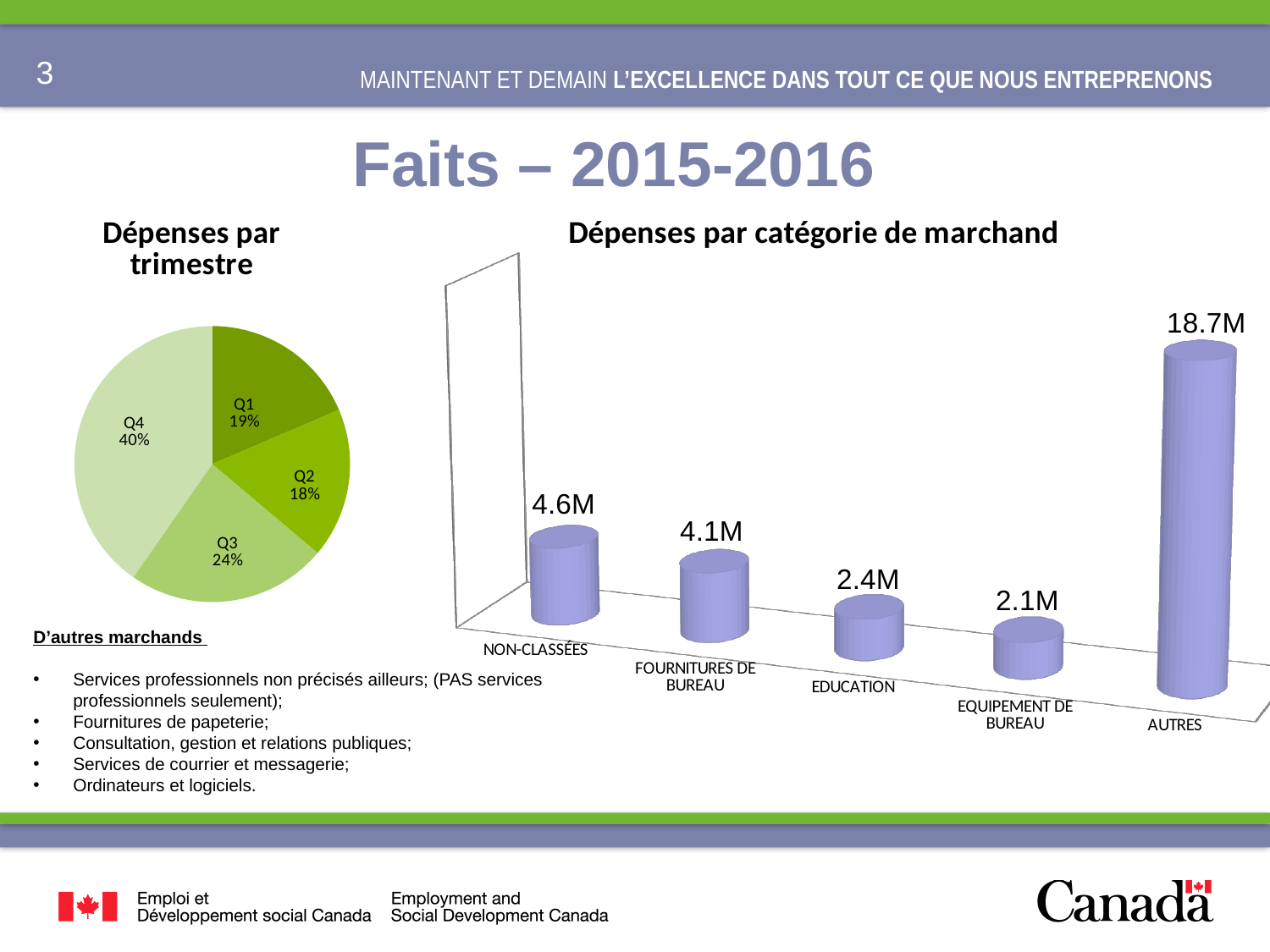
In the 'Dépenses par catégorie de marchand' chart, what is the value for EDUCATION? 2.4M In the 'Dépenses par catégorie de marchand' chart, which category has the highest value? AUTRES In the 'Dépenses par catégorie de marchand' chart, what is the difference between NON-CLASSÉES and FOURNITURES DE BUREAU? 0.5M In the 'Dépenses par catégorie de marchand' chart, what is the value for AUTRES? 18.7M What kind of chart is 'Dépenses par trimestre'? Pie chart In the 'Dépenses par trimestre' pie chart, what share does Q4 have? 40% What kind of chart is 'Dépenses par catégorie de marchand'? Bar chart In the 'Dépenses par catégorie de marchand' chart, how many categories are shown? 5 In the 'Dépenses par trimestre' pie chart, what is the value for Q3? 24% In the 'Dépenses par catégorie de marchand' chart, which category has the lowest value? EQUIPEMENT DE BUREAU In the 'Dépenses par trimestre' pie chart, which is larger, Q1 or Q3? Q3 In the 'Dépenses par trimestre' pie chart, which quarter has the smallest share? Q2